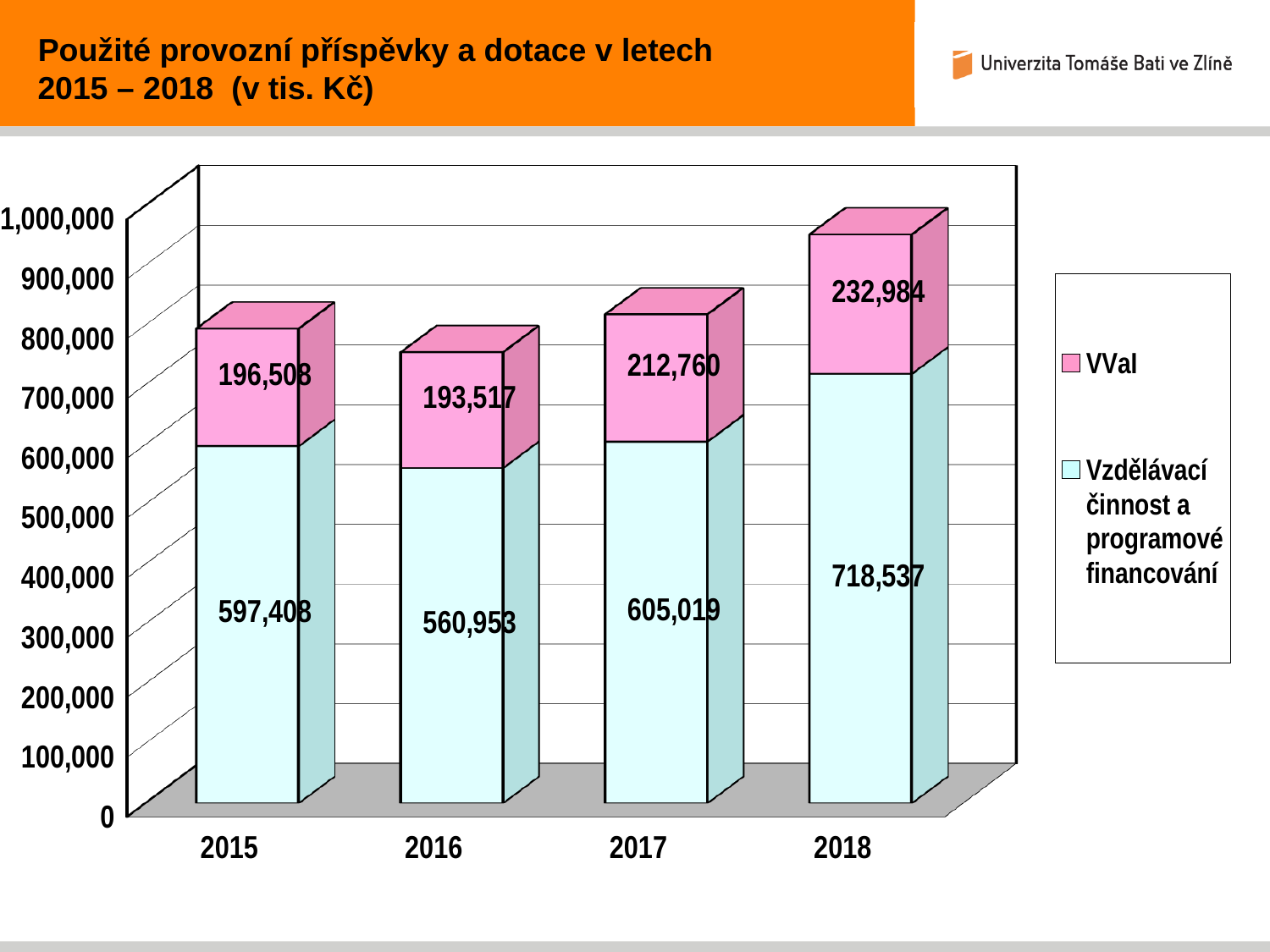
Which is larger: the VVaI value in 2015 or in 2016? 2015 What is the value of VVaI in 2016? 193,517 What is the total of the stacked bar for 2016? 754,470 What kind of chart is shown on the slide? Stacked bar chart How many years are shown on the x axis? 4 What is the total of the stacked bar for 2018? 951,521 What is the value of VVaI in 2017? 212,760 What is the value of Vzdělávací činnost a programové financování in 2018? 718,537 In which year is the VVaI value the highest? 2018 How many series does the legend list? 2 In which year is the Vzdělávací činnost a programové financování value the lowest? 2016 What is the difference between the Vzdělávací činnost a programové financování values for 2018 and 2015? 121,129